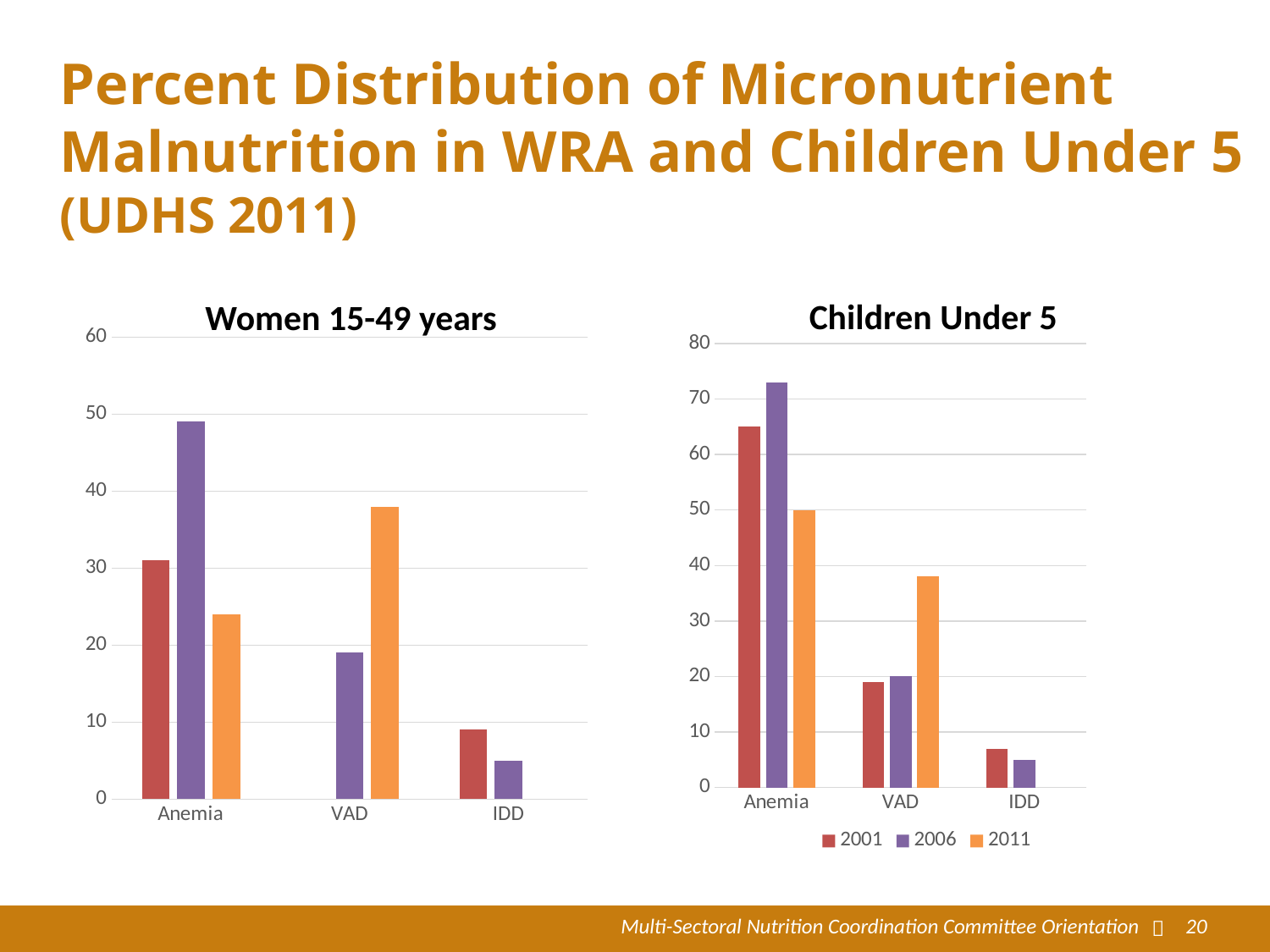
In the 'Women 15-49 years' chart, which category has the highest 2006 value? Anemia In the 'Women 15-49 years' chart, which is larger for Anemia: the 2001 value or the 2011 value? 2001 In the 'Children Under 5' chart, which is larger for Anemia: the 2001 value or the 2006 value? 2006 What kind of chart is the 'Women 15-49 years' chart? bar chart In the 'Children Under 5' chart, is the 2006 value for Anemia greater or less than 70? greater In the 'Children Under 5' chart, which category has the lowest 2006 value? IDD How many series does the legend of the 'Children Under 5' chart list? 3 In the 'Women 15-49 years' chart, is the 2006 value for Anemia greater or less than 40? greater In the 'Children Under 5' chart, do the VAD values rise or fall from 2001 to 2011? rise In the 'Women 15-49 years' chart, is the 2011 value for VAD greater or less than 30? greater How many categories are shown on the x axis of the 'Women 15-49 years' chart? 3 What are the legend entries of the 'Children Under 5' chart? 2001, 2006, 2011